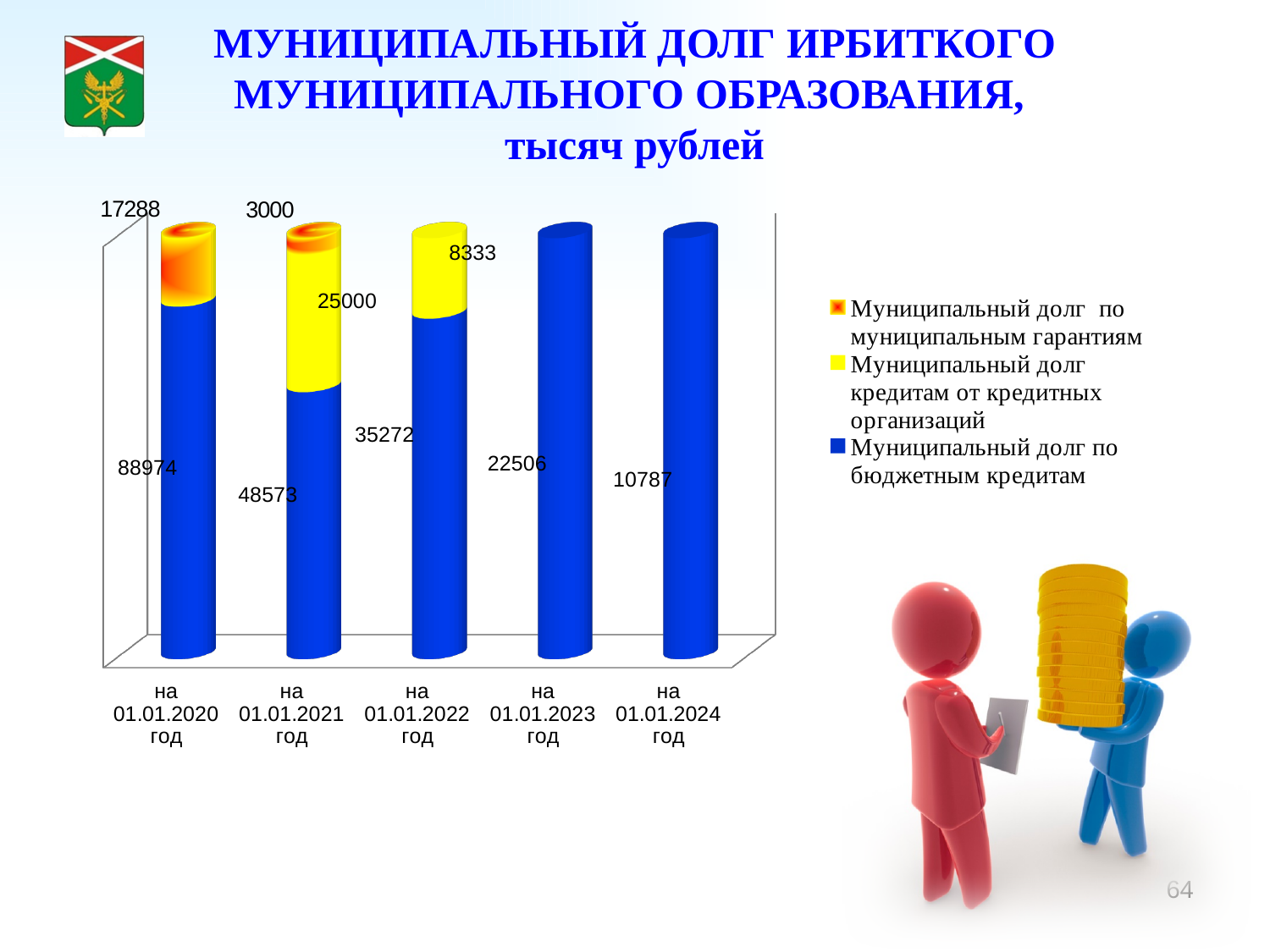
Which is larger: municipal debt on credits from credit organizations as of 01.01.2021 or as of 01.01.2022? на 01.01.2021 год How many series does the legend list? 3 On which date is municipal debt on budget credits the lowest? на 01.01.2024 год What is the total municipal debt as of 01.01.2021 (sum of all three segments of that bar)? 76573 What is the difference between municipal debt on budget credits as of 01.01.2022 and as of 01.01.2023? 12766 What is the value of municipal debt on credits from credit organizations as of 01.01.2021? 25000 What is the value of municipal debt on municipal guarantees as of 01.01.2021? 3000 On which date is municipal debt on budget credits the highest? на 01.01.2020 год How many dates (categories) are shown on the x axis of the chart? 5 What is the value of municipal debt on budget credits as of 01.01.2024? 10787 What kind of chart is shown on the slide? bar chart What is the value of municipal debt on budget credits (Муниципальный долг по бюджетным кредитам) as of 01.01.2020? 88974